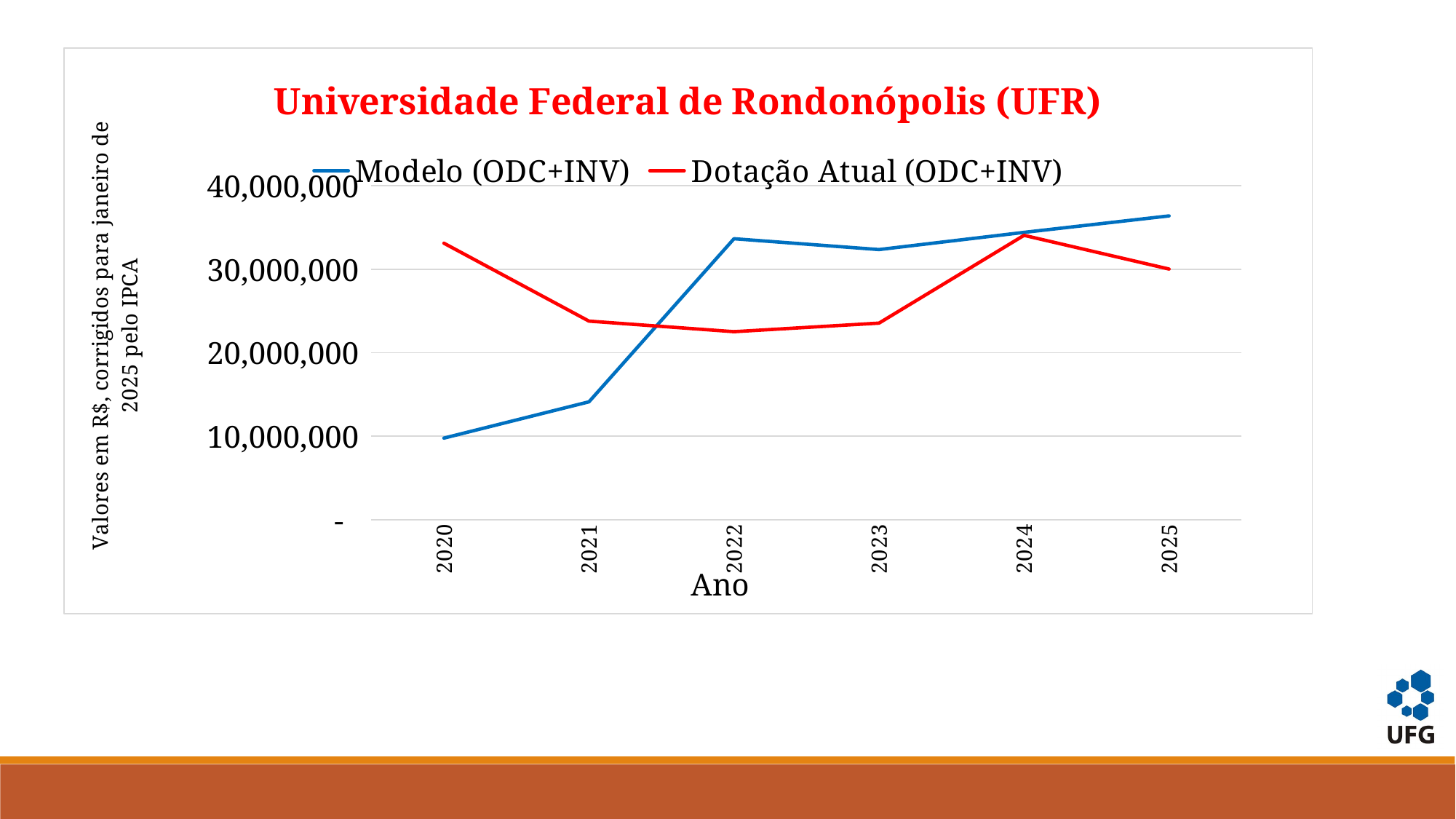
What is the title of the chart? Universidade Federal de Rondonópolis (UFR) Is the value for Dotação Atual (ODC+INV) in 2022 greater or less than 20,000,000? greater What kind of chart is shown on the slide? Line chart In 2020, which series has the larger value, Modelo (ODC+INV) or Dotação Atual (ODC+INV)? Dotação Atual (ODC+INV) Which series is drawn in red? Dotação Atual (ODC+INV) In 2025, which series has the larger value, Modelo (ODC+INV) or Dotação Atual (ODC+INV)? Modelo (ODC+INV) How many years are shown on the x axis? 6 Is the value for Dotação Atual (ODC+INV) in 2020 greater or less than 30,000,000? greater Is the value for Modelo (ODC+INV) in 2022 greater or less than 30,000,000? greater In which year is the Modelo (ODC+INV) series at its lowest? 2020 How many series does the legend list? 2